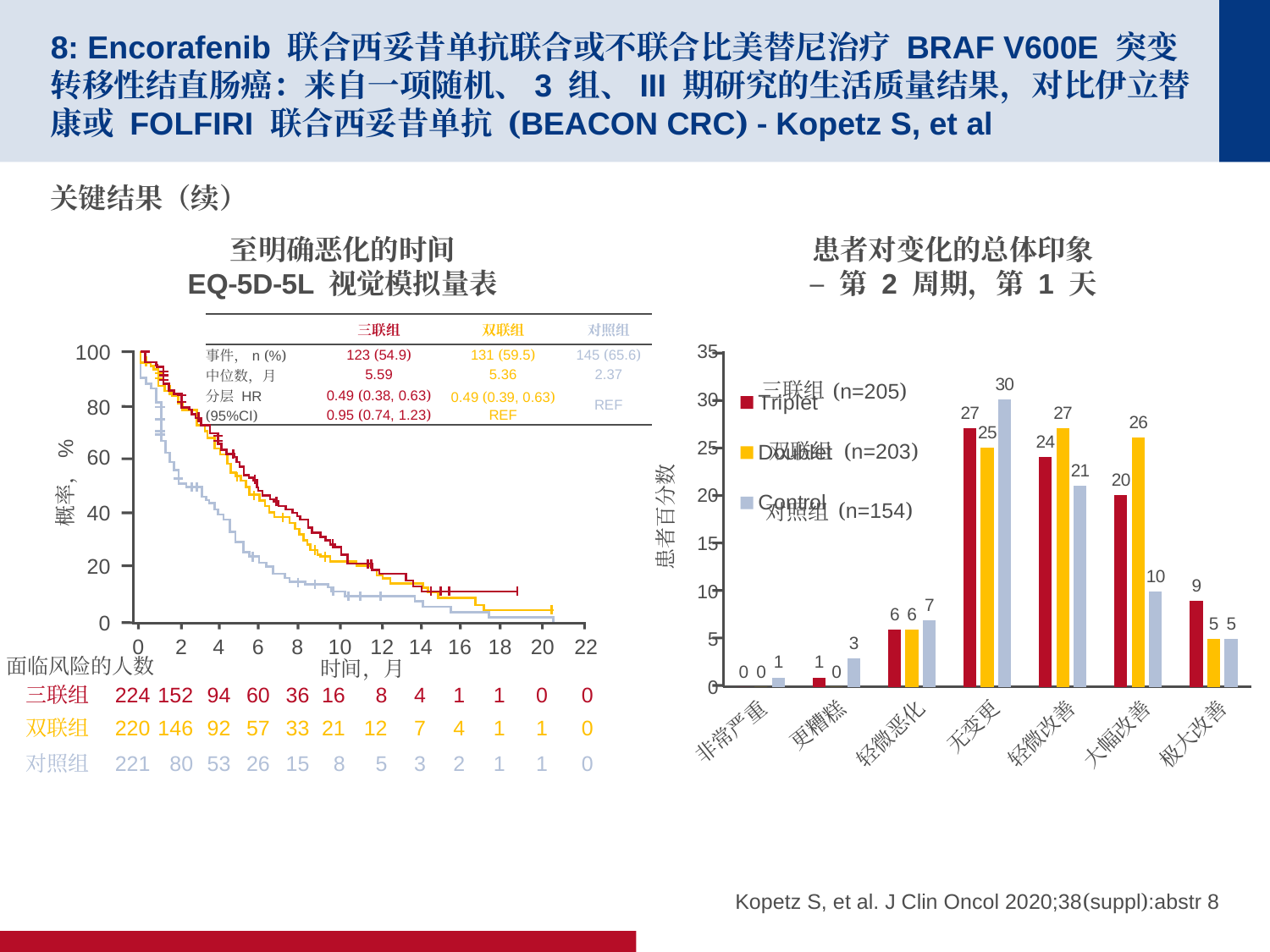
In the right-hand bar chart, how many series does the legend list? 3 What kind of chart is the right-hand chart titled 患者对变化的总体印象 – 第 2 周期, 第 1 天? bar chart In the right-hand bar chart, how many categories are shown on the x axis? 7 In the right-hand bar chart, what is the value for 三联组 (Triplet) in the 轻微改善 category? 24 In the right-hand bar chart, which category has the highest value for 对照组 (Control)? 无变更 What kind of chart is the left-hand chart titled 至明确恶化的时间 EQ-5D-5L 视觉模拟量表? line chart In the right-hand bar chart, what is the value for 对照组 (Control) in the 无变更 category? 30 In the left-hand chart's inset table, what is the median (中位数, 月) for 对照组? 2.37 In the right-hand bar chart, what is the difference between the 双联组 (Doublet) and 对照组 (Control) values in the 大幅改善 category? 16 In the right-hand bar chart, what is the value for 双联组 (Doublet) in the 无变更 category? 25 In the right-hand bar chart, which is larger in the 极大改善 category: 三联组 (Triplet) or 双联组 (Doublet)? 三联组 (Triplet) In the left-hand chart, what is the number at risk (面临风险的人数) for 三联组 at time 0? 224